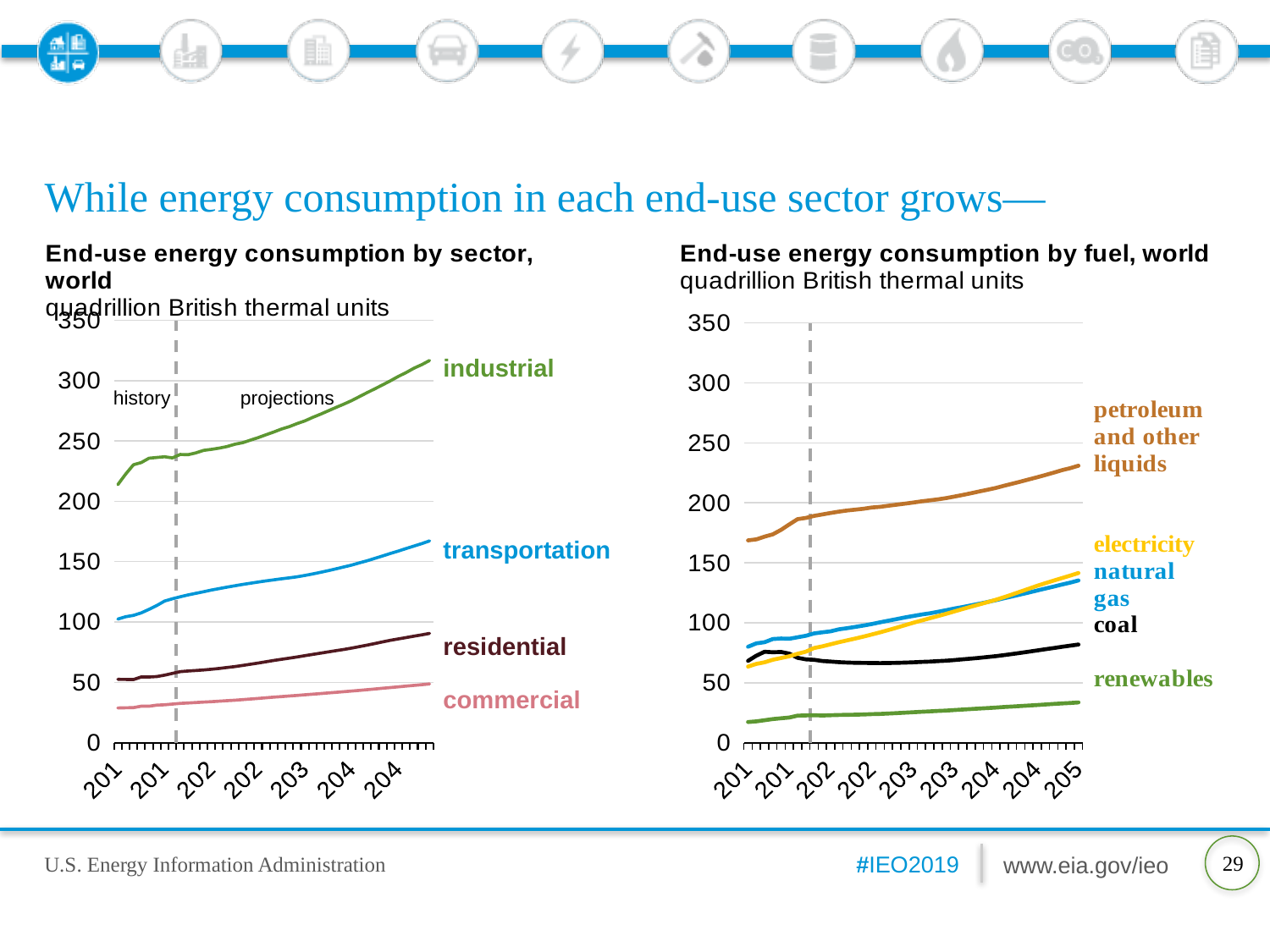
In the 'End-use energy consumption by sector, world' chart, is the industrial value at the end of the projection period greater or less than 300? greater In the 'End-use energy consumption by sector, world' chart, how many sector series are plotted? 4 In the 'End-use energy consumption by sector, world' chart, which sector has the highest consumption? industrial In the 'End-use energy consumption by fuel, world' chart, which fuel has the lowest consumption? renewables In the 'End-use energy consumption by fuel, world' chart, which is larger at the end of the projection period, coal or renewables? coal In the 'End-use energy consumption by sector, world' chart, which sector has the lowest consumption? commercial In the 'End-use energy consumption by fuel, world' chart, is the petroleum and other liquids value at the end of the projection period greater or less than 200? greater In the 'End-use energy consumption by sector, world' chart, is the residential value at the end of the projection period greater or less than 100? less In the 'End-use energy consumption by fuel, world' chart, which fuel has the highest consumption? petroleum and other liquids What kind of chart is the 'End-use energy consumption by sector, world' chart? line chart In the 'End-use energy consumption by sector, world' chart, does industrial consumption rise or fall over the period shown? rise In the 'End-use energy consumption by fuel, world' chart, how many fuel series are plotted? 5